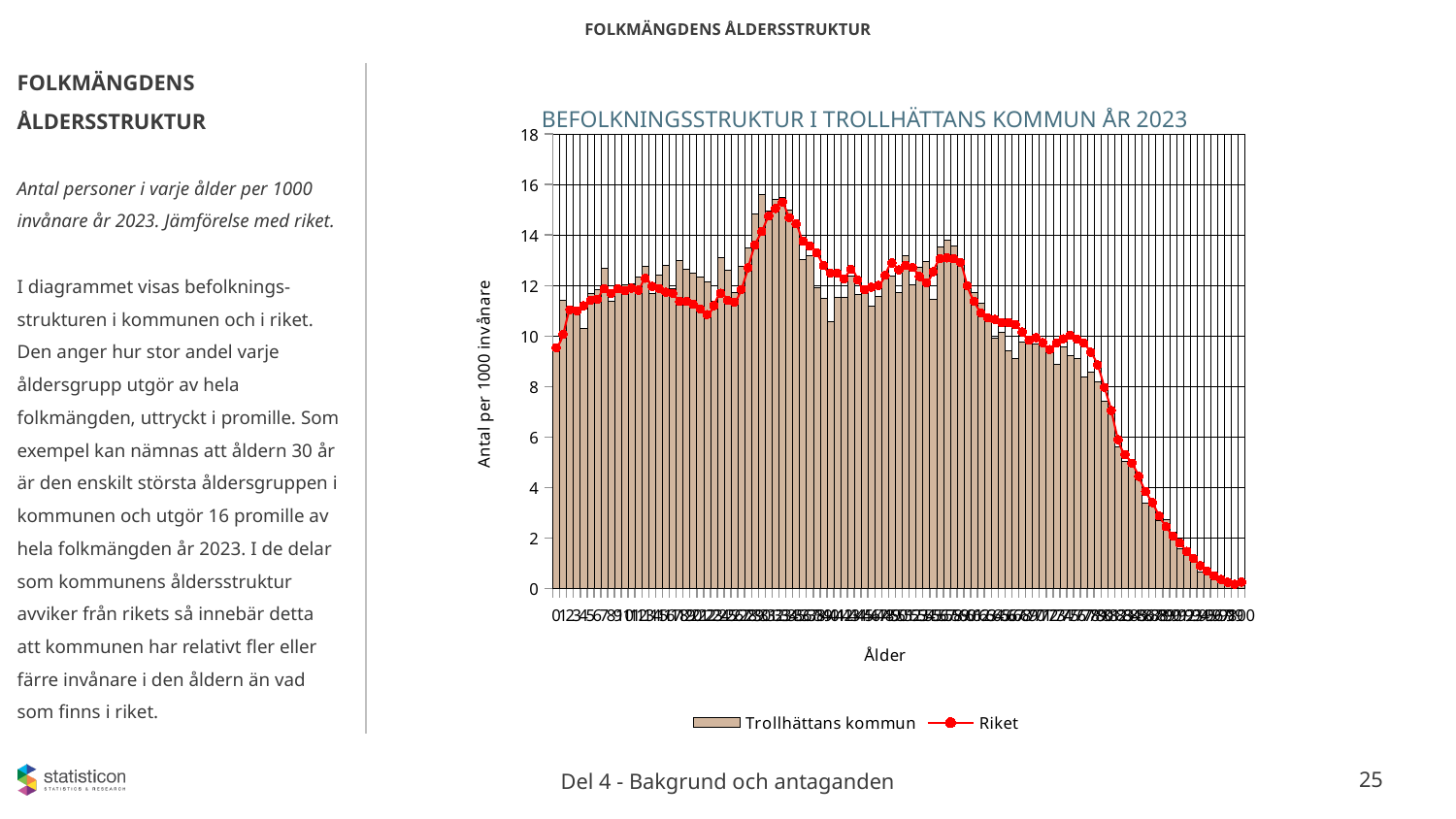
Which series is drawn as a red line with markers? Riket What is the title of the chart on the slide? BEFOLKNINGSSTRUKTUR I TROLLHÄTTANS KOMMUN ÅR 2023 What kind of chart is shown on the slide? A bar chart with a line overlay Is the value of the last bar at the right end of the x axis greater or less than 2? less What is the label of the chart's vertical axis? Antal per 1000 invånare Which two series are listed in the chart's legend? Trollhättans kommun and Riket How many series does the chart's legend list? 2 Is the highest bar for Trollhättans kommun greater or less than 14? greater What is the label of the chart's horizontal axis? Ålder Is the peak value of the Riket line greater or less than 16? less Toward the right end of the x axis (the oldest ages), do the values rise or fall? fall What is the highest tick value shown on the chart's vertical axis? 18